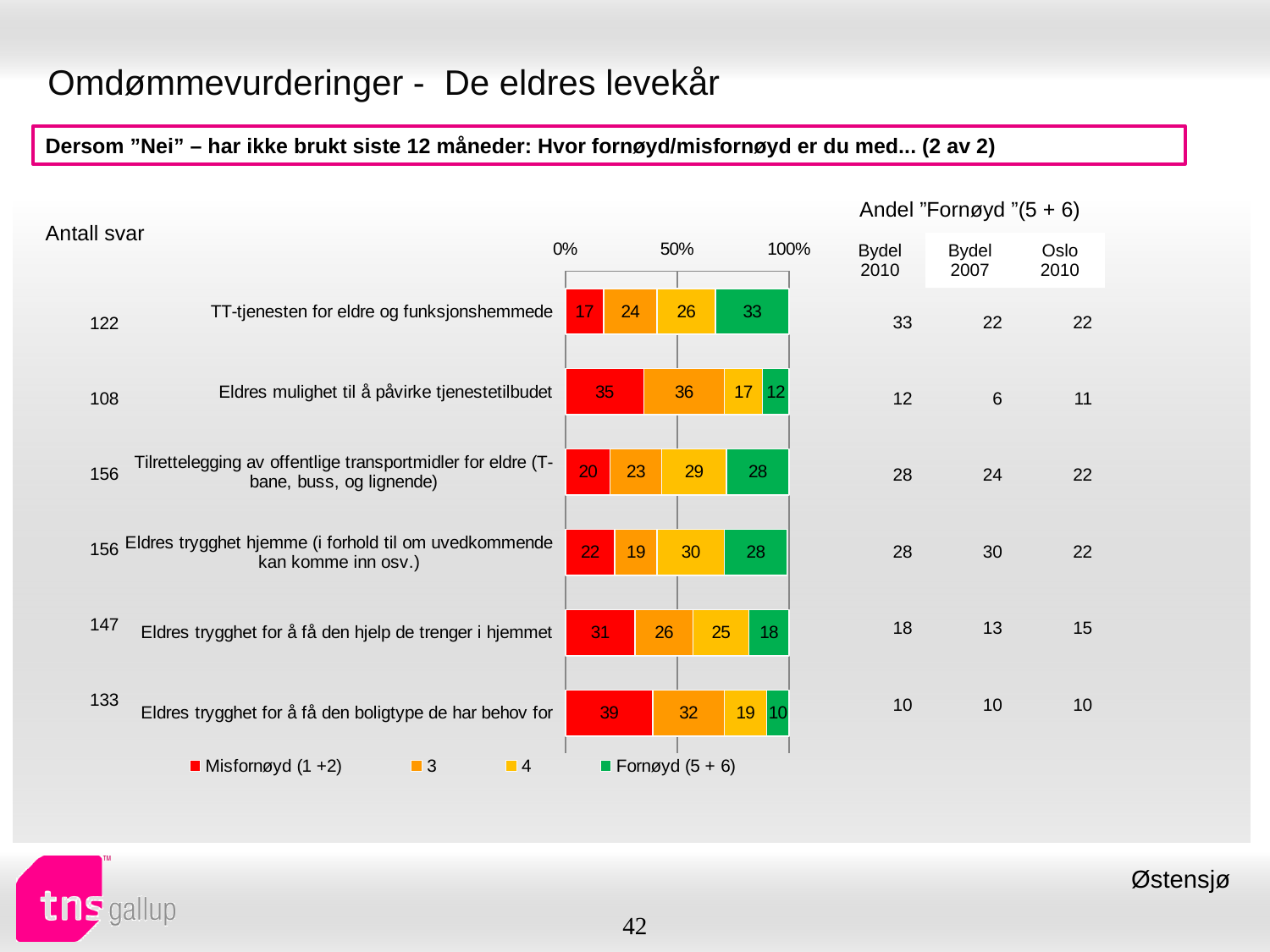
Which category has the highest "Fornøyd (5 + 6)" value? TT-tjenesten for eldre og funksjonshemmede What is the difference between the "Misfornøyd (1 +2)" values for Eldres trygghet for å få den boligtype de har behov for and TT-tjenesten for eldre og funksjonshemmede? 22 Which category has the lowest "Fornøyd (5 + 6)" value? Eldres trygghet for å få den boligtype de har behov for How many series does the legend list? 4 What is the total of the stacked bar for Eldres trygghet for å få den hjelp de trenger i hjemmet? 100 What is the value of series "4" for Eldres trygghet hjemme (i forhold til om uvedkommende kan komme inn osv.)? 30 What kind of chart is shown on the slide? Stacked bar chart What is the "Misfornøyd (1 +2)" value for Eldres trygghet for å få den boligtype de har behov for? 39 What is the value of series "3" for Eldres mulighet til å påvirke tjenestetilbudet? 36 How many categories are shown in the chart? 6 Which is larger: the "Fornøyd (5 + 6)" value for Tilrettelegging av offentlige transportmidler for eldre or for Eldres trygghet for å få den hjelp de trenger i hjemmet? Tilrettelegging av offentlige transportmidler for eldre What percentage of respondents were "Fornøyd (5 + 6)" with TT-tjenesten for eldre og funksjonshemmede? 33